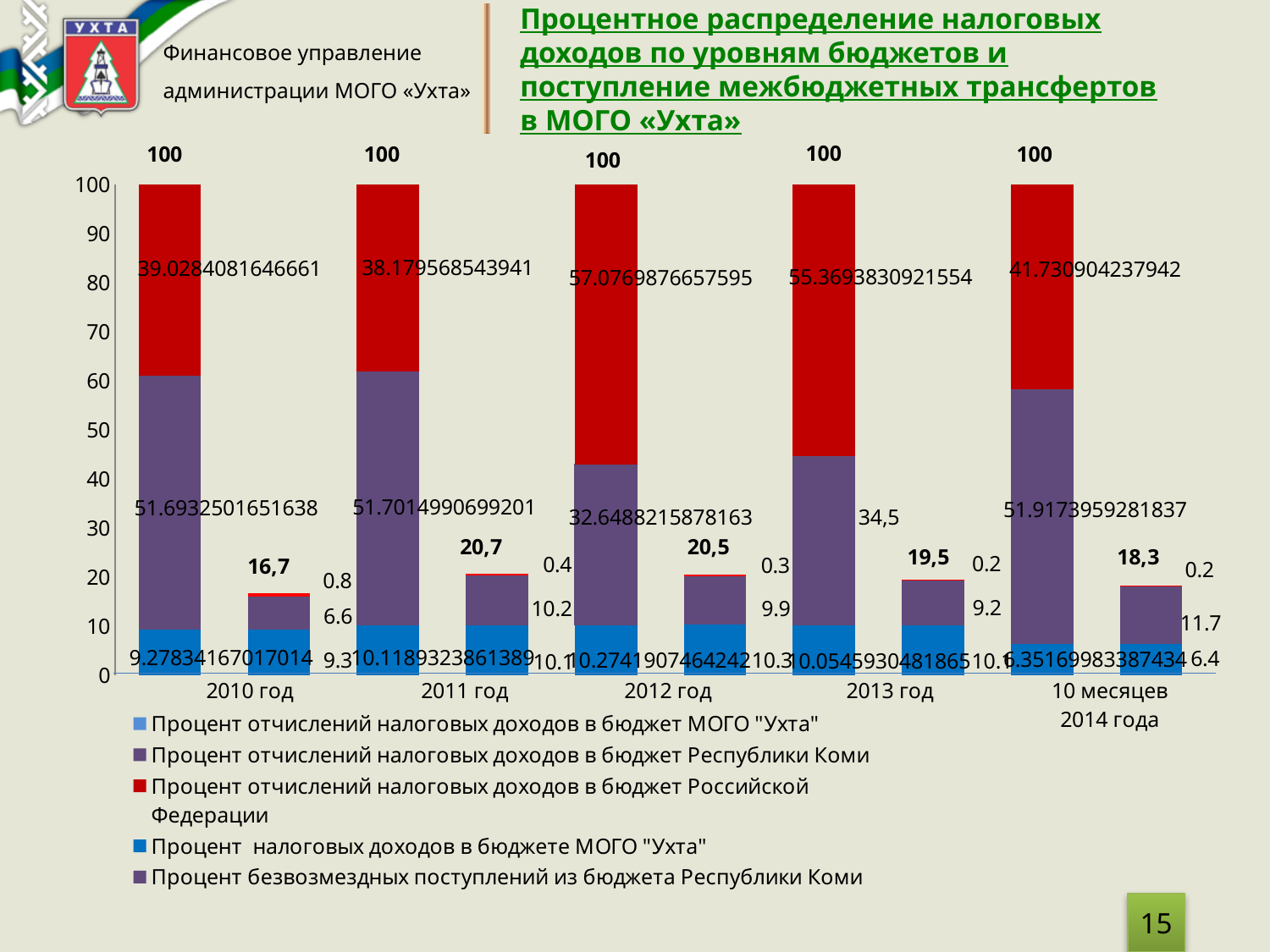
What is the total of the shorter stacked bar for 2011 год? 20,7 What kind of chart is shown on the slide? Stacked bar chart In which year is the total of the shorter stacked bar the lowest? 2010 год How many series does the legend list? 5 How many year categories are shown along the x axis? 5 Is the 'Процент отчислений налоговых доходов в бюджет Республики Коми' value for 2012 год greater or less than 40? less In which year is the total of the shorter stacked bar the highest? 2011 год What is the value of 'Процент безвозмездных поступлений из бюджета Республики Коми' for 10 месяцев 2014 года? 11.7 What is the difference between the 'Процент безвозмездных поступлений из бюджета Республики Коми' values for 10 месяцев 2014 года (11.7) and 2010 год (6.6)? 5.1 What is the value of 'Процент отчислений налоговых доходов в бюджет Республики Коми' for 2013 год? 34,5 Which year has the larger 'Процент отчислений налоговых доходов в бюджет Российской Федерации' value, 2010 год or 2012 год? 2012 год What is the value of 'Процент отчислений налоговых доходов в бюджет Российской Федерации' for 2012 год? 57.0769876657595